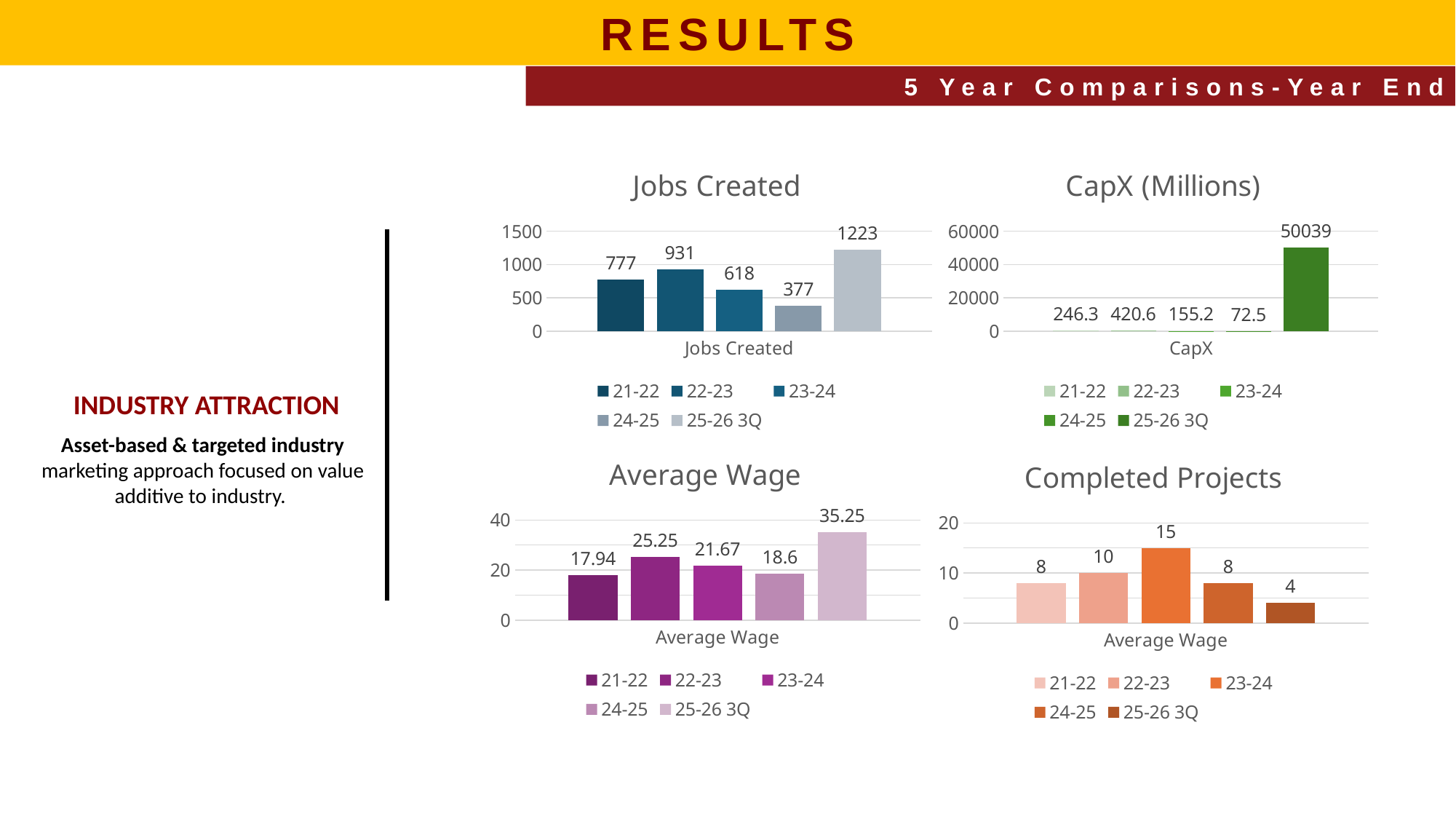
In the Average Wage chart, what is the value for 23-24? 21.67 How many series does the legend of the Completed Projects chart list? 5 In the CapX (Millions) chart, which is larger, the 22-23 value or the 23-24 value? 22-23 In the CapX (Millions) chart, which series has the highest value? 25-26 3Q What kind of chart is the Jobs Created chart? Bar chart In the CapX (Millions) chart, what is the value for 24-25? 72.5 In the Jobs Created chart, what is the difference between the 22-23 and 21-22 values? 154 In the Completed Projects chart, what is the difference between the 23-24 and 25-26 3Q values? 11 In the Average Wage chart, which series has the lowest value? 21-22 In the Completed Projects chart, what is the value for 23-24? 15 In the Jobs Created chart, which series has the lowest value? 24-25 In the Jobs Created chart, what is the value for 25-26 3Q? 1223